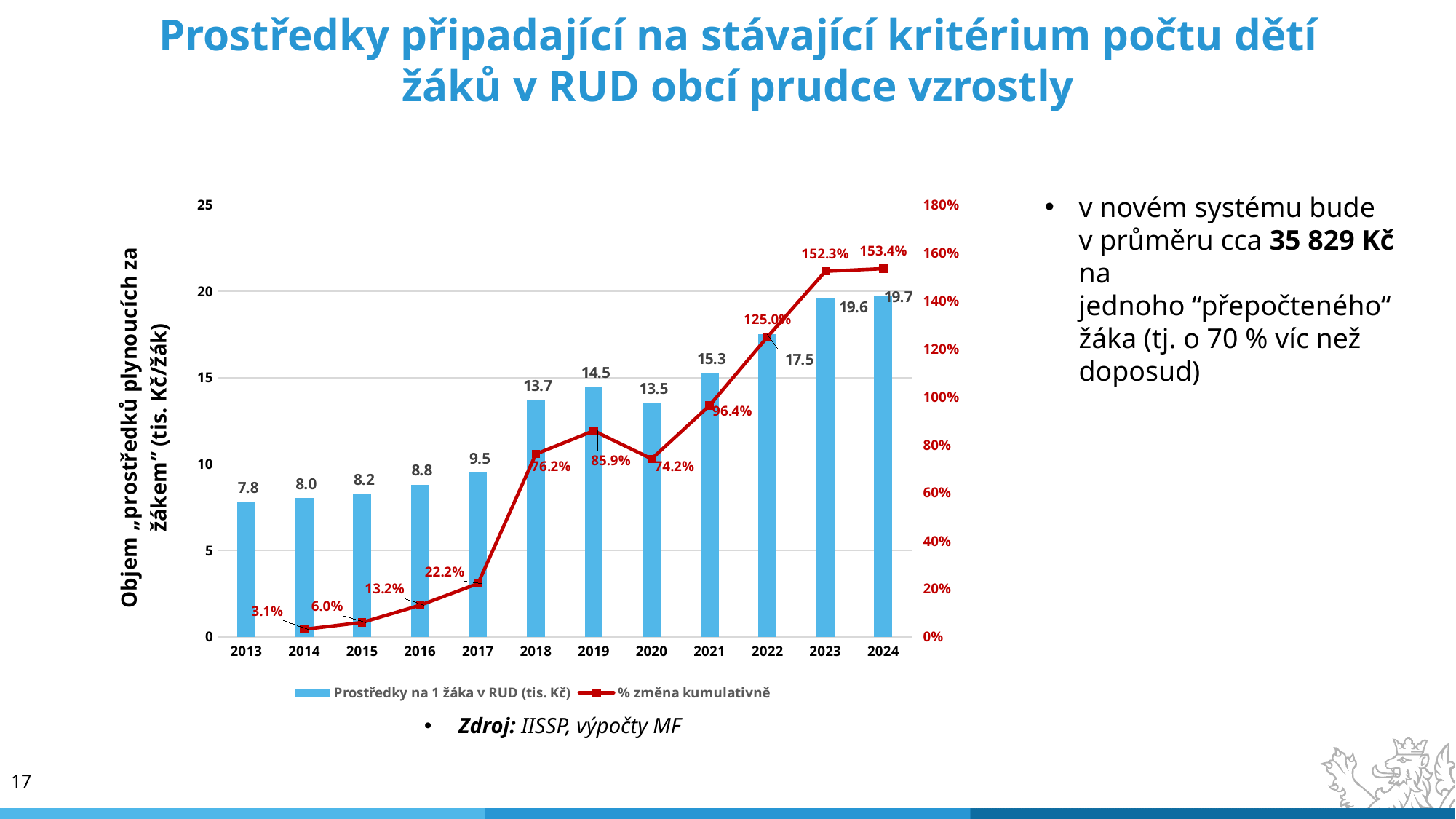
What kind of chart is used for the 'Prostředky na 1 žáka v RUD (tis. Kč)' series? bar chart What is the label of the left vertical axis of the chart? Objem „prostředků plynoucích za žákem" (tis. Kč/žák) Which is larger, the 'Prostředky na 1 žáka v RUD (tis. Kč)' value for 2019 or for 2020? 2019 What is the value of 'Prostředky na 1 žáka v RUD (tis. Kč)' for 2018? 13.7 Does the '% změna kumulativně' line rise or fall between 2019 and 2020? fall Which year has the highest value of 'Prostředky na 1 žáka v RUD (tis. Kč)'? 2024 What is the '% změna kumulativně' value for 2022? 125.0% What is the difference between the 'Prostředky na 1 žáka v RUD (tis. Kč)' values for 2022 and 2021? 2.2 Which year has the lowest value of 'Prostředky na 1 žáka v RUD (tis. Kč)'? 2013 How many series does the chart legend list? 2 Is the '% změna kumulativně' value for 2021 greater or less than 100%? less How many years are shown on the x axis of the chart? 12